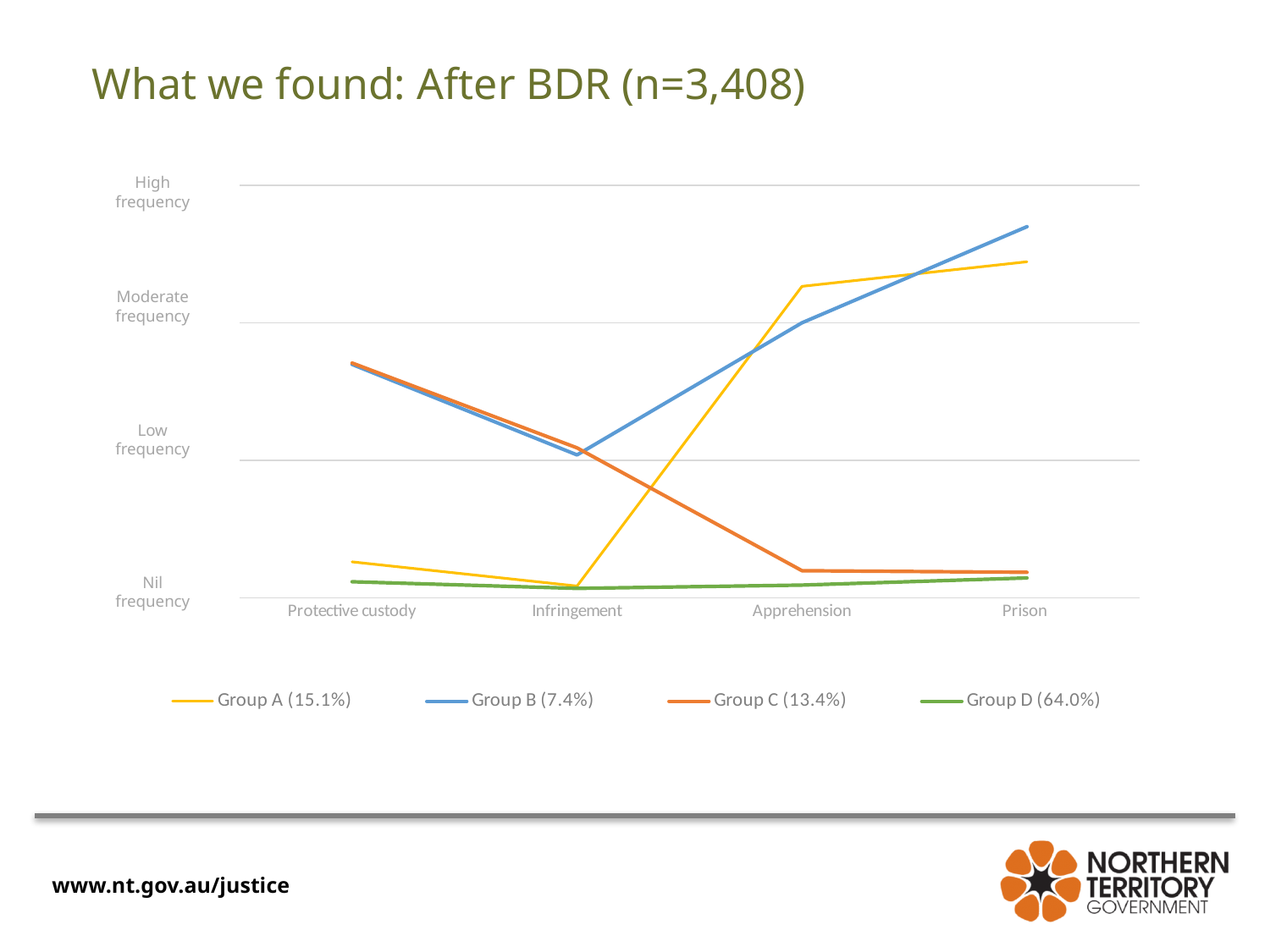
What is the full legend label for the green series? Group D (64.0%) How many categories are shown along the x axis? 4 Which group has the lowest value at Apprehension? Group D (64.0%) Is the value for Group B at Prison above or below the Moderate frequency line? above Which group has the highest value at Apprehension? Group A (15.1%) What kind of chart is shown on the slide? line chart At Prison, which is higher: Group A or Group C? Group A Does the Group C line rise or fall from Protective custody to Prison? fall How many series does the legend list? 4 What is the title of the slide containing the chart? What we found: After BDR (n=3,408) Which group has the highest value at Prison? Group B (7.4%) Is the value for Group C at Prison above or below the Low frequency line? below